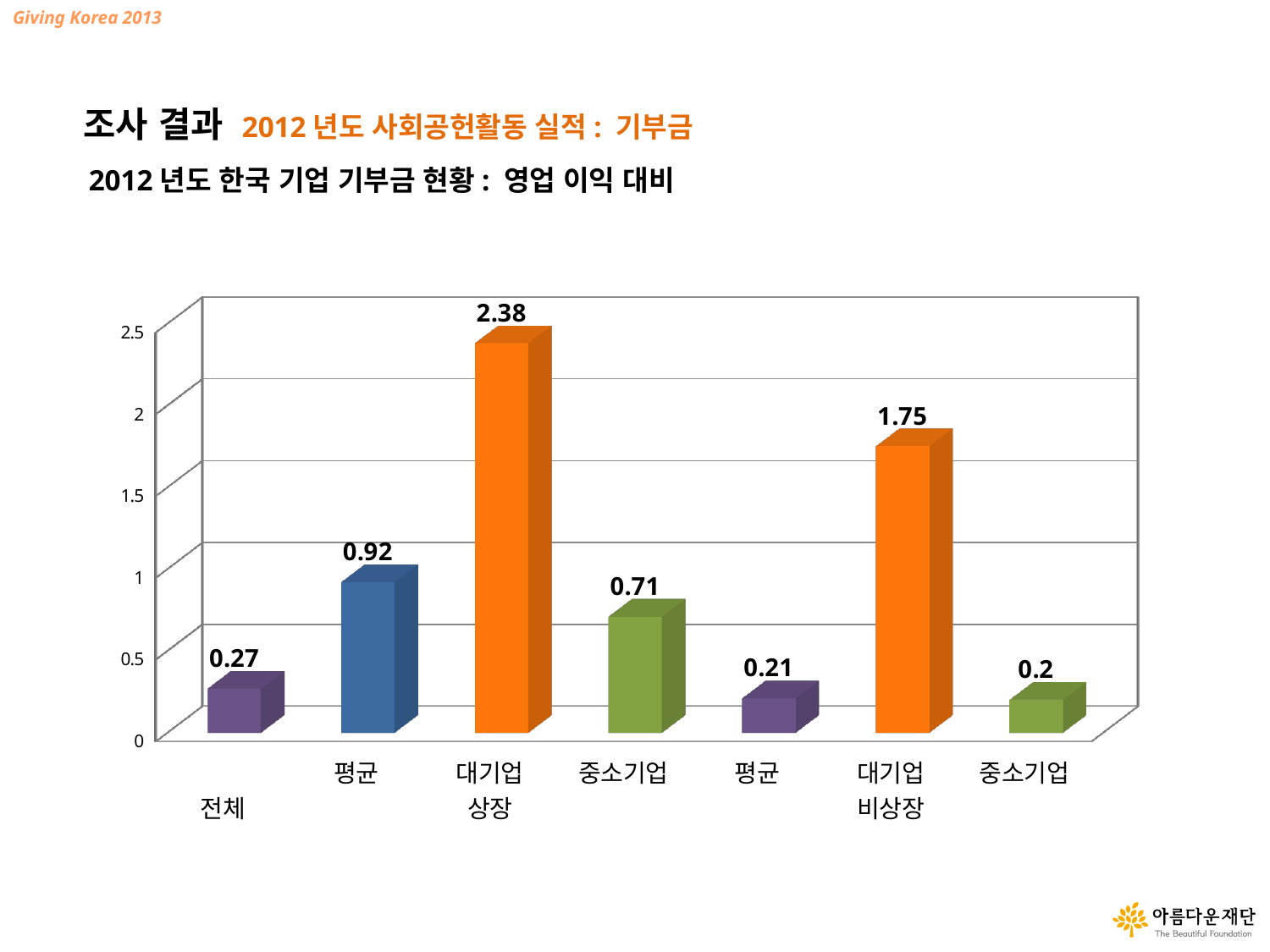
What is the title of the chart on the slide? 2012 년도 한국 기업 기부금 현황 : 영업 이익 대비 Which category has the highest value? 대기업 상장 What is the difference between the values for 대기업 상장 and 대기업 비상장? 0.63 What is the value for 전체? 0.27 What is the value for the 중소기업 bar in the 비상장 group (rightmost bar)? 0.2 Which category has the lowest value? 중소기업 (비상장, rightmost bar) What is the value for 대기업 상장? 2.38 Which is larger: the 평균 value in the 상장 group or the 평균 value in the 비상장 group? 평균 in the 상장 group (0.92) What is the value for the 평균 bar in the 상장 group (second bar from the left)? 0.92 What is the value for 대기업 비상장? 1.75 What kind of chart is shown on the slide? Bar chart How many bars are plotted in the chart? 7